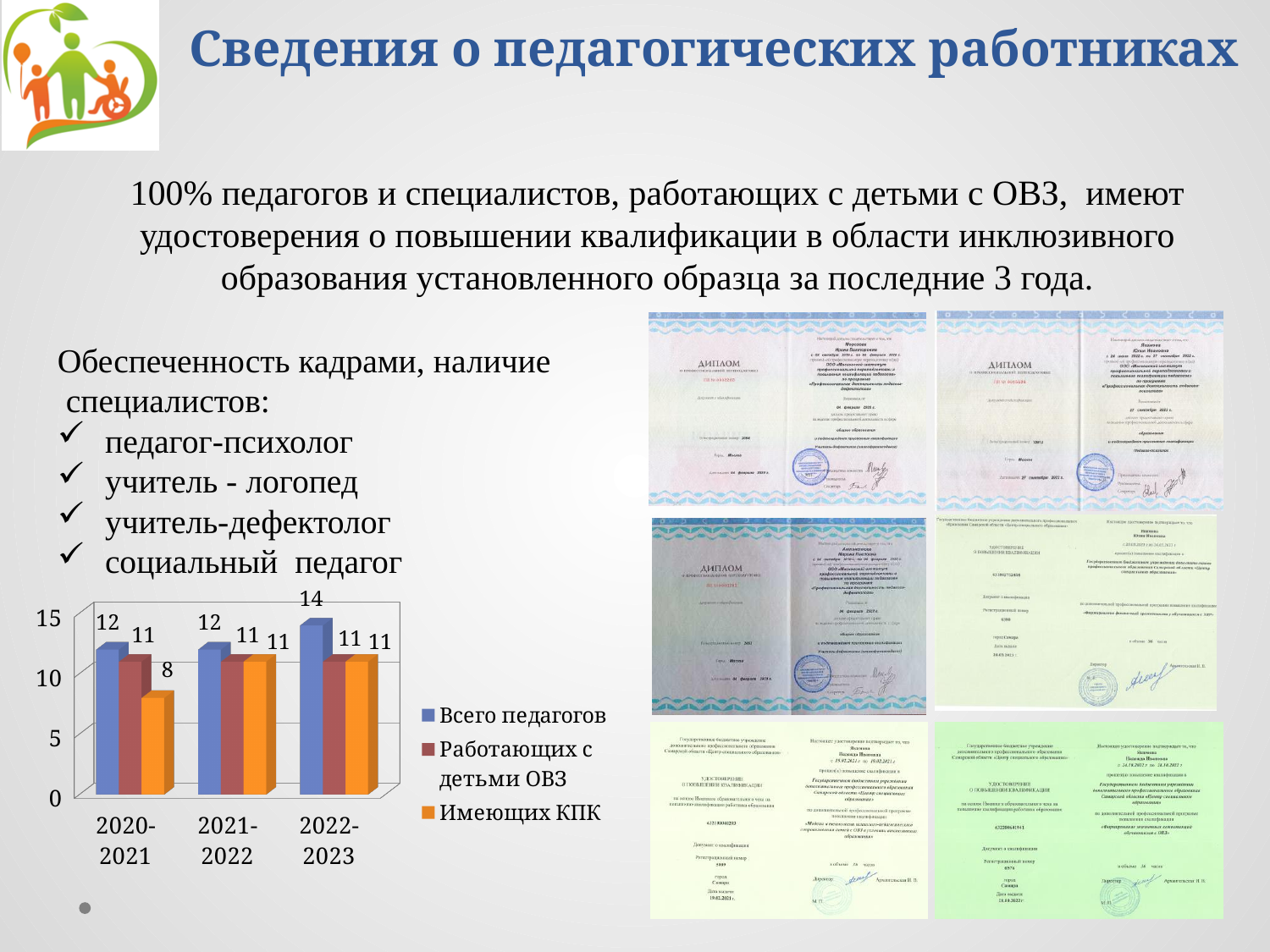
How many categories (academic years) are shown on the x axis of the chart? 3 In which academic year is the value for Имеющих КПК the lowest? 2020-2021 Which is larger in 2022-2023: Всего педагогов or Работающих с детьми ОВЗ? Всего педагогов What is the value for Всего педагогов in 2022-2023? 14 What type of chart is shown on the slide? bar chart Which colour represents the series Имеющих КПК in the chart? orange How many series does the chart legend list? 3 In which academic year is the value for Всего педагогов the highest? 2022-2023 Does the value for Всего педагогов rise or fall from 2021-2022 to 2022-2023? rise What is the value for Имеющих КПК in 2020-2021? 8 What is the difference between Всего педагогов and Имеющих КПК in 2020-2021? 4 What is the value for Работающих с детьми ОВЗ in 2021-2022? 11